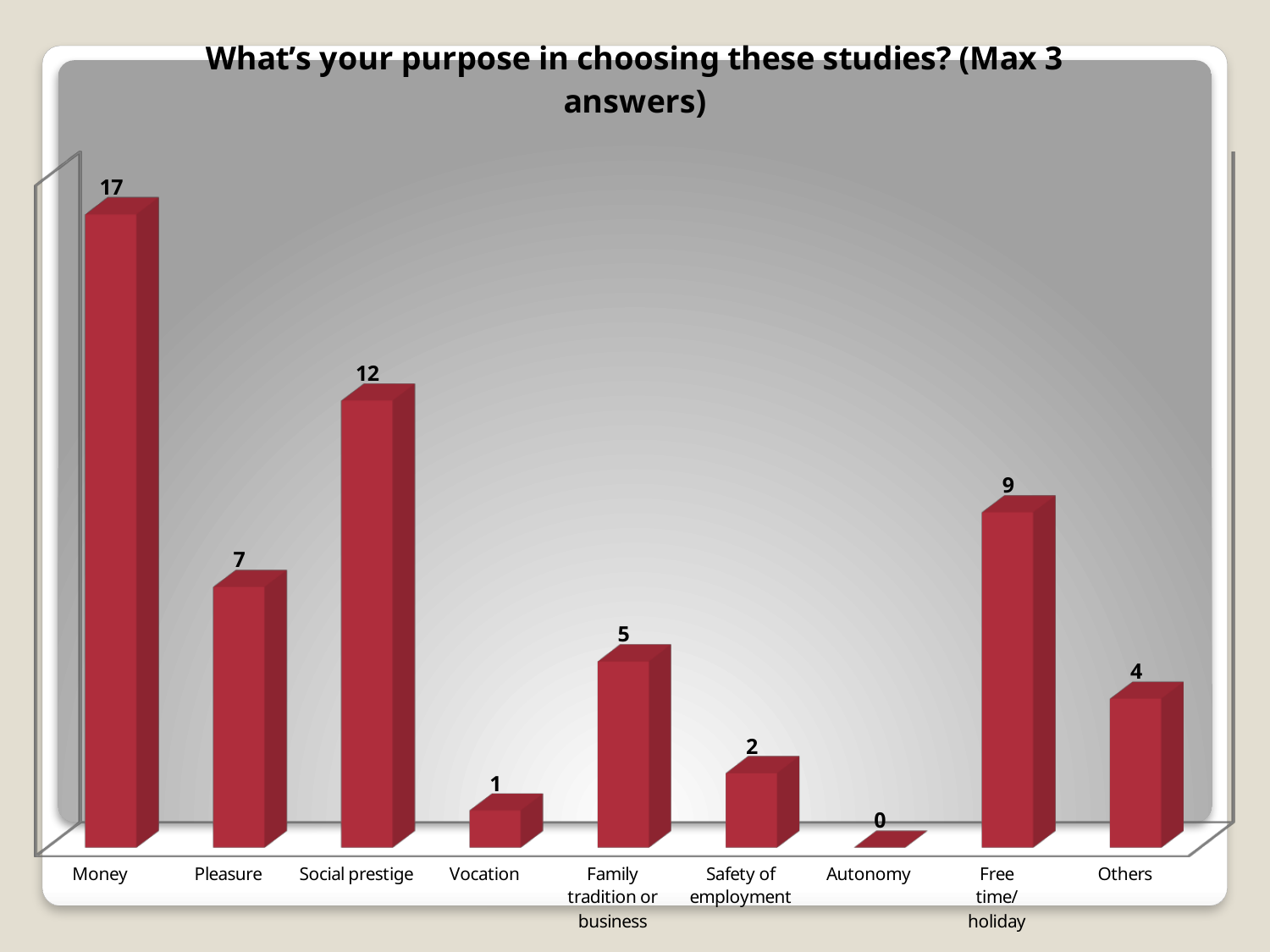
Which category has the lowest value? Autonomy What is the value for Free time/ holiday? 9 What kind of chart is this? Bar chart What is the title of the chart? What's your purpose in choosing these studies? (Max 3 answers) What is the value for Family tradition or business? 5 How many categories are shown on the x axis? 9 Which is larger, the value for Pleasure or the value for Free time/ holiday? Free time/ holiday What is the difference between the values for Money and Social prestige? 5 What is the difference between the values for Pleasure and Others? 3 Which category has the highest value? Money Which is larger, the value for Vocation or the value for Safety of employment? Safety of employment What is the value for Money? 17